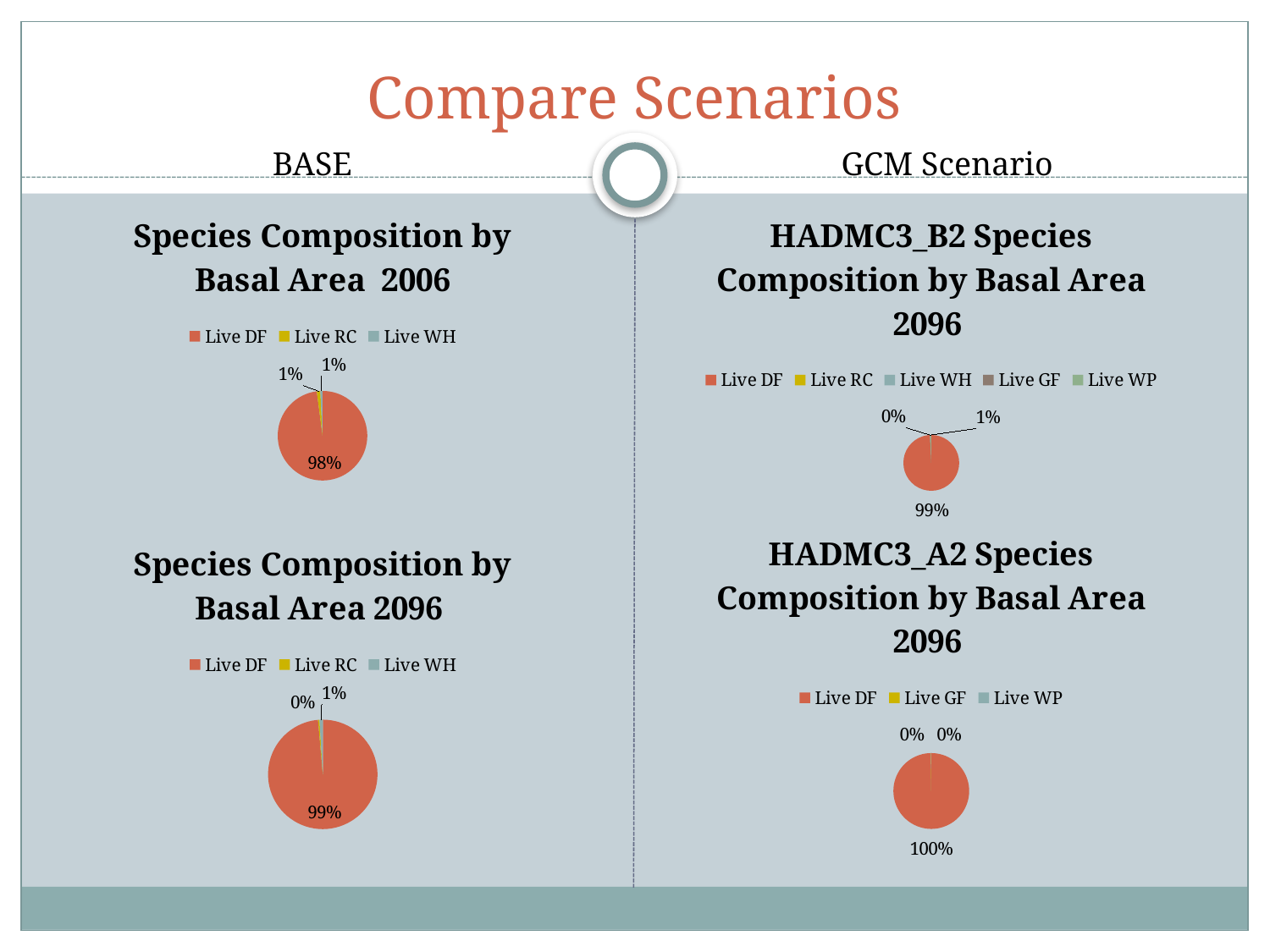
Which species has the largest slice in the 'HADMC3_A2 Species Composition by Basal Area 2096' chart? Live DF How many entries does the legend of the 'HADMC3_B2 Species Composition by Basal Area 2096' chart list? 5 How many entries does the legend of the 'Species Composition by Basal Area 2006' chart list? 3 What type of chart is the 'Species Composition by Basal Area 2006' chart? pie chart In the 'HADMC3_B2 Species Composition by Basal Area 2096' chart, what share does Live DF have? 99% How many pie charts are shown on the slide? 4 In the 'Species Composition by Basal Area 2096' chart on the left, what share does Live DF have? 99% Which species has the largest slice in the 'Species Composition by Basal Area 2006' chart? Live DF How many entries does the legend of the 'HADMC3_A2 Species Composition by Basal Area 2096' chart list? 3 Is the Live DF share in the 'Species Composition by Basal Area 2006' chart larger or smaller than in the 'HADMC3_A2 Species Composition by Basal Area 2096' chart? smaller In the 'HADMC3_A2 Species Composition by Basal Area 2096' chart, what share does Live DF have? 100%